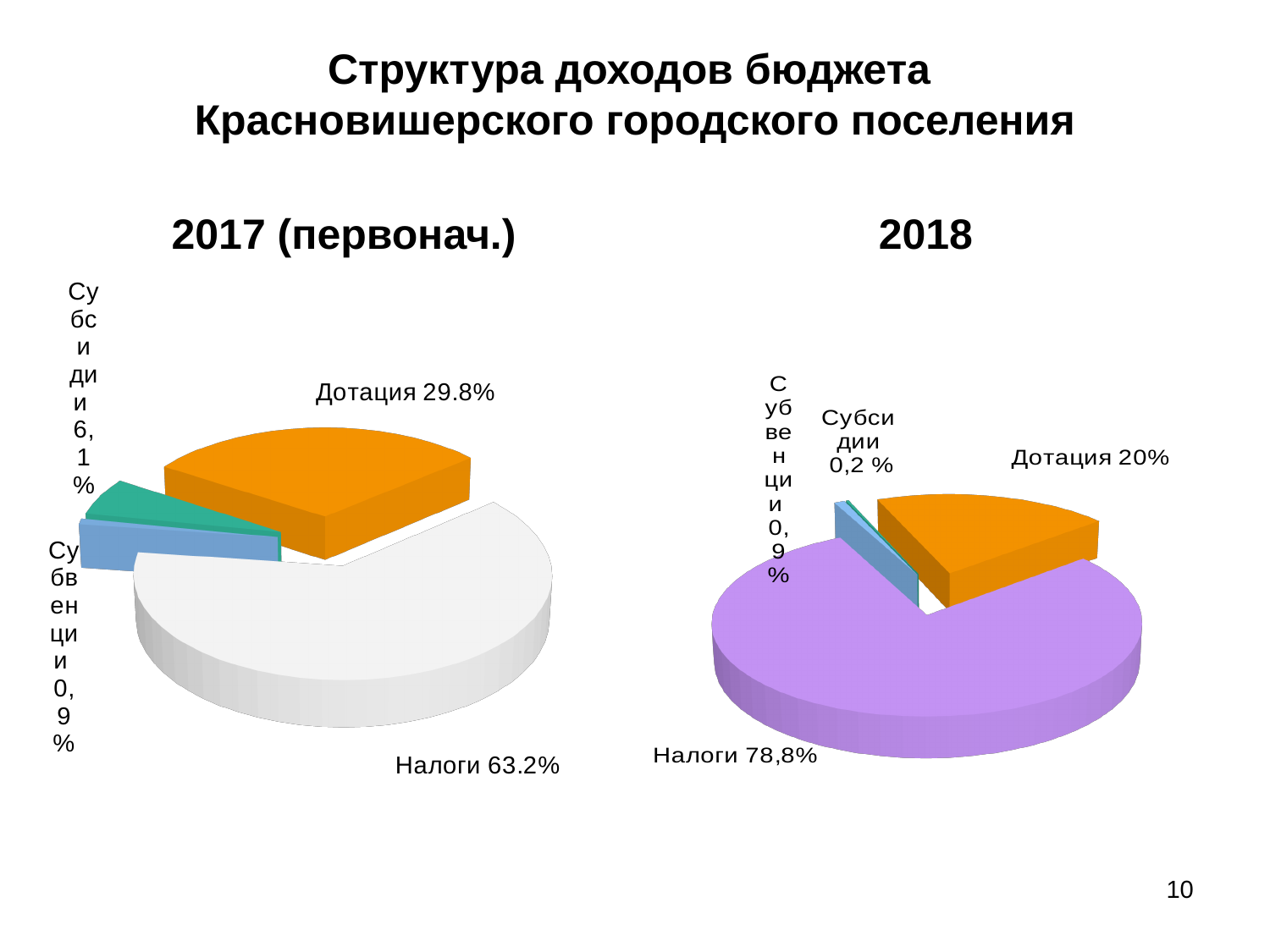
What is the title of the slide? Структура доходов бюджета Красновишерского городского поселения How many slices does the 2018 chart have? 4 In the 2017 (первонач.) chart, what share is labelled for Дотация? 29.8% In the 2018 chart, what share is labelled for Дотация? 20% What type of chart is used for 2018? Pie chart In the 2018 chart, which category has the smallest slice? Субсидии In the 2017 (первонач.) chart, which category has the largest slice? Налоги In the 2017 (первонач.) chart, which is larger: Дотация or Субсидии? Дотация In the 2017 (первонач.) chart, what share is labelled for Субсидии? 6,1% In the 2017 (первонач.) chart, what share is labelled for Налоги? 63.2% In the 2018 chart, what share is labelled for Налоги? 78,8% In the 2018 chart, what share is labelled for Субвенции? 0,9%